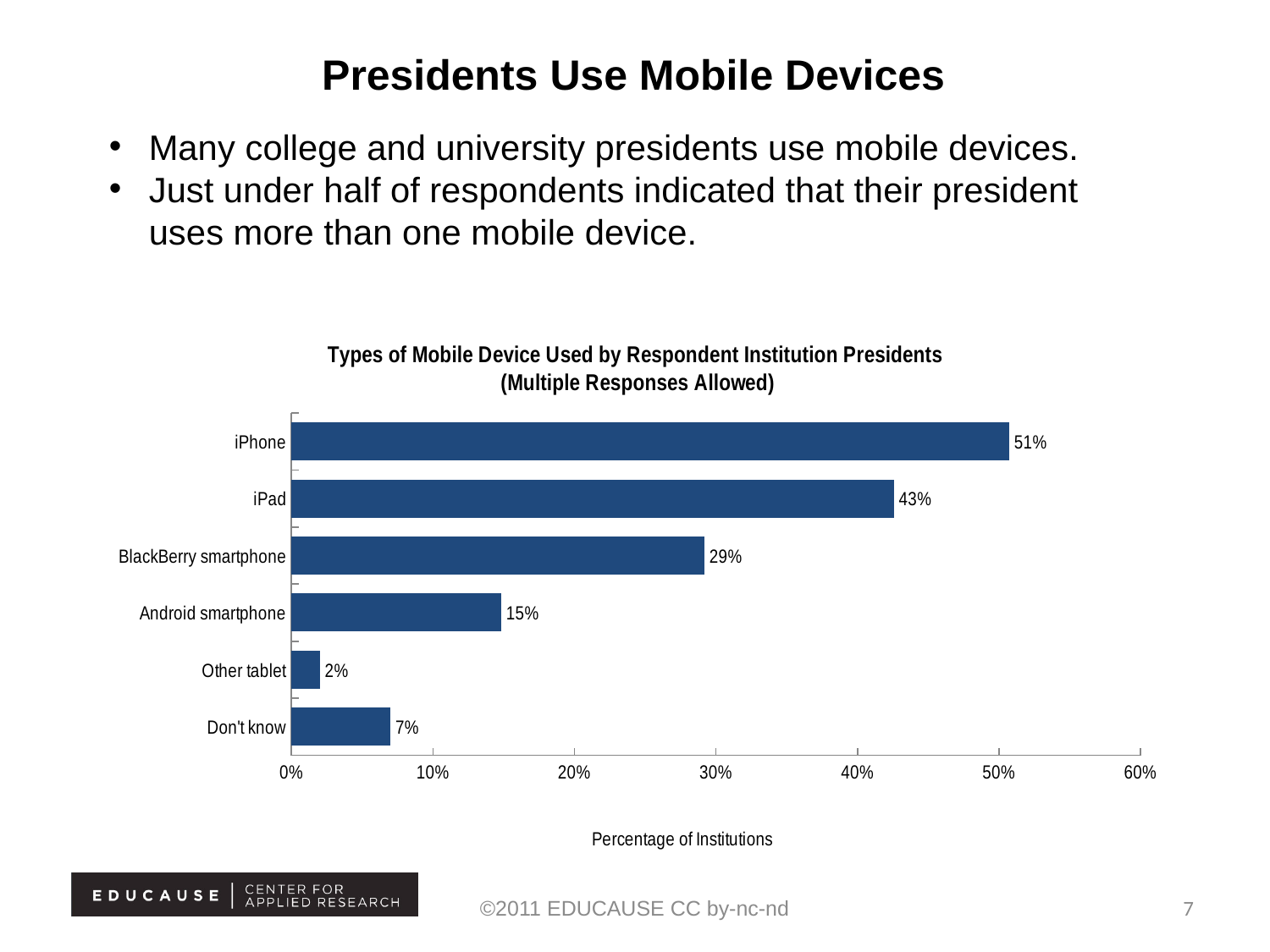
What is the difference between Android smartphone and Don't know? 8% What is the label of the horizontal axis of the chart? Percentage of Institutions Which device category has the lowest percentage? Other tablet What is the difference in percentage points between iPhone and iPad? 8% Which device category has the highest percentage? iPhone What is the value for Other tablet? 2% Is the value for Android smartphone greater or less than 20%? less What is the value for BlackBerry smartphone? 29% What kind of chart is shown on the slide? Bar chart How many device categories are shown in the chart? 6 What percentage of institutions report that their president uses an iPhone? 51% Which is larger, the value for iPad or the value for BlackBerry smartphone? iPad